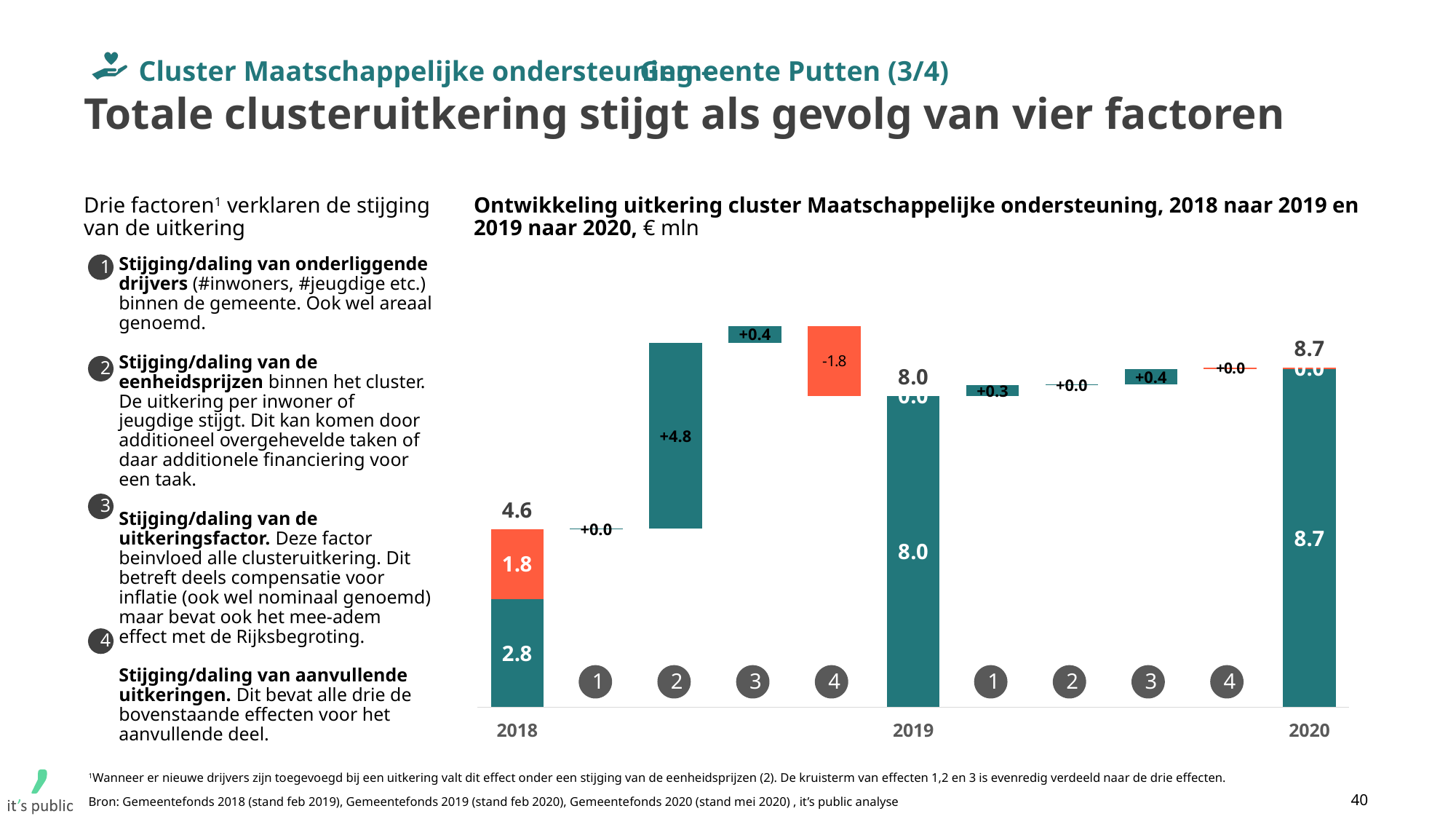
What is the effect of factor 2 between 2018 and 2019? +4.8 In what unit are the values in the chart expressed? € mln What is the total uitkering shown for 2018? 4.6 What is the value of the teal segment in the 2018 bar? 2.8 Do the yearly totals rise or fall from 2018 to 2020? Rise What is the effect of factor 4 between 2018 and 2019? -1.8 What is the value of the orange segment in the 2018 bar? 1.8 What is the difference between the 2020 total and the 2018 total? 4.1 What is the total uitkering shown for 2019? 8.0 Which factor has the largest effect between 2018 and 2019? Factor 2 What is the total uitkering shown for 2020? 8.7 What is the effect of factor 1 between 2019 and 2020? +0.3